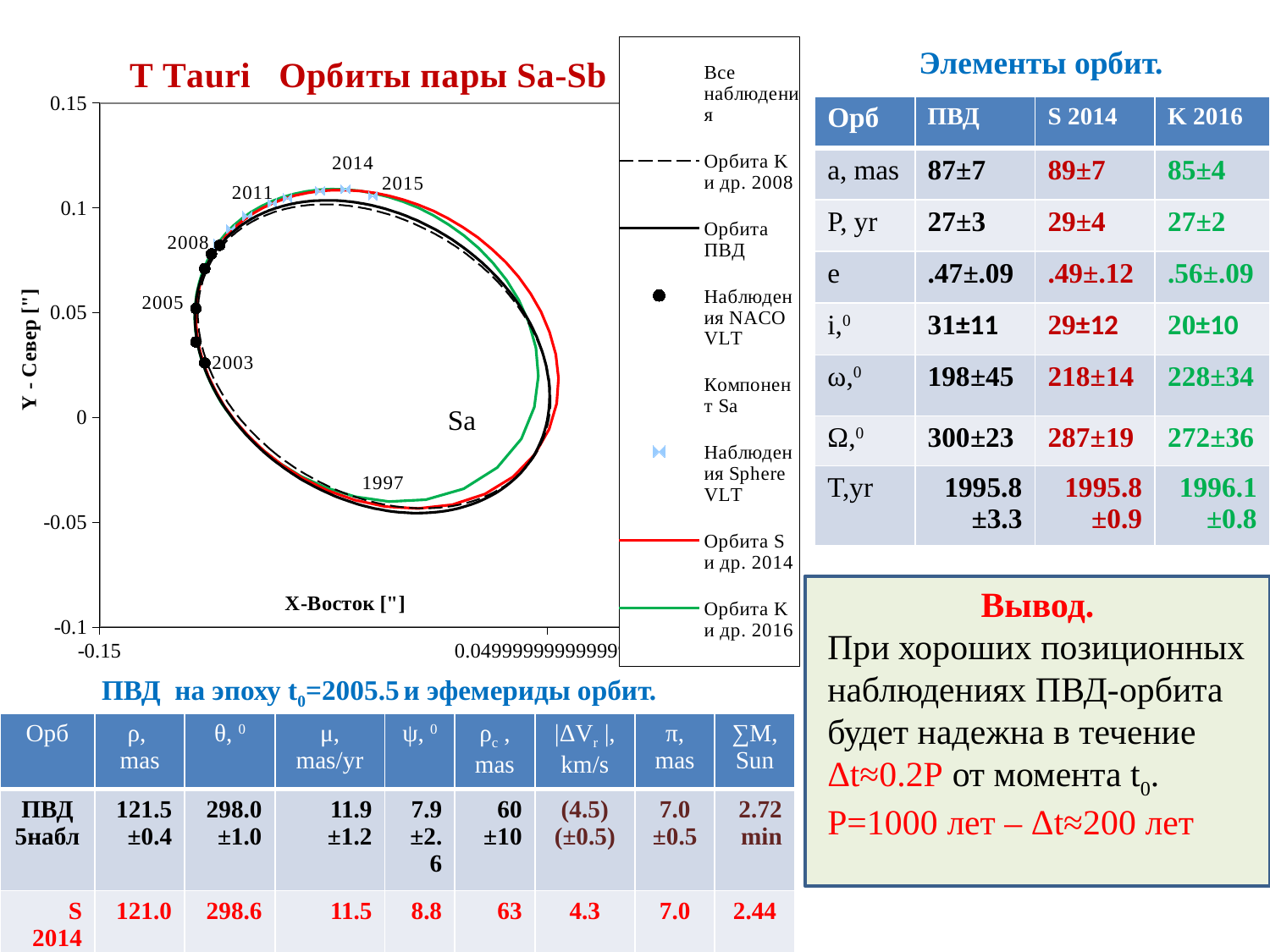
On the orbit chart, is the Y value of the 1997 observation greater or less than 0? less How many year labels are printed next to observation points on the orbit chart? 7 On the orbit chart, is the Y value of the 2011 observation greater or less than 0.05? greater What is the title of the chart on the left of the slide? T Tauri Орбиты пары Sa-Sb On the orbit chart, is the Y value of the 2003 observation greater or less than 0.05? less On the orbit chart, which labelled observation year has the lowest Y value? 1997 On the orbit chart, which observation point is higher on the Y axis, 2003 or 2014? 2014 What is the label of the vertical axis of the orbit chart? Y - Север ["] What kind of chart is the T Tauri orbit chart? scatter (line) chart How many entries does the legend of the orbit chart list? 8